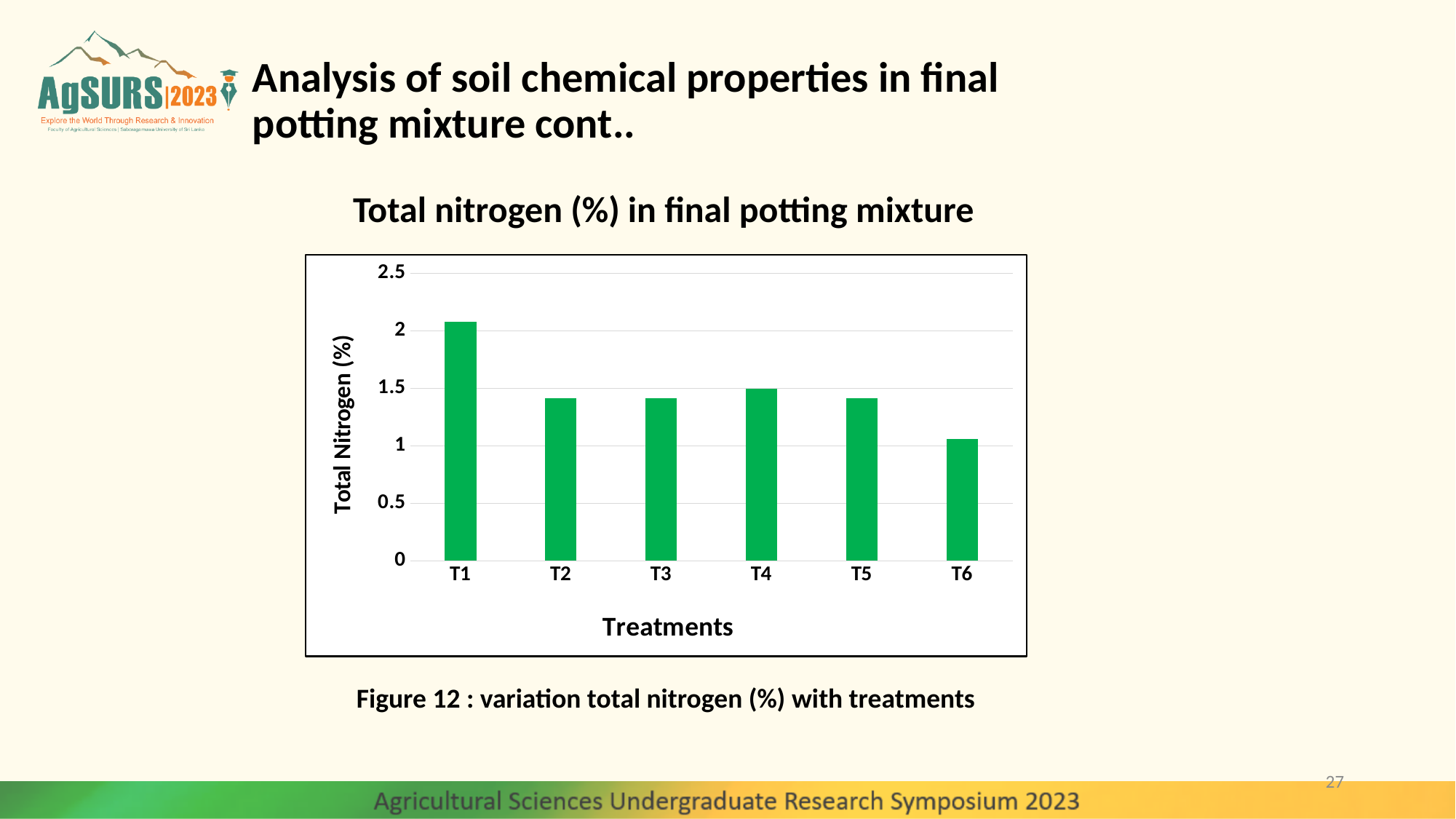
Is the total nitrogen value for T2 greater or less than 1.5? less What is the label of the x axis of the chart? Treatments Which has a higher total nitrogen (%), T4 or T6? T4 What kind of chart is shown on the slide? bar chart Is the total nitrogen value for T6 greater or less than 1.5? less Is the total nitrogen value for T1 greater or less than 2? greater Which has a higher total nitrogen (%), T1 or T2? T1 How many treatments are plotted on the x axis? 6 What is the title of the chart? Total nitrogen (%) in final potting mixture Which treatment has the highest total nitrogen (%)? T1 Which treatment has the lowest total nitrogen (%)? T6